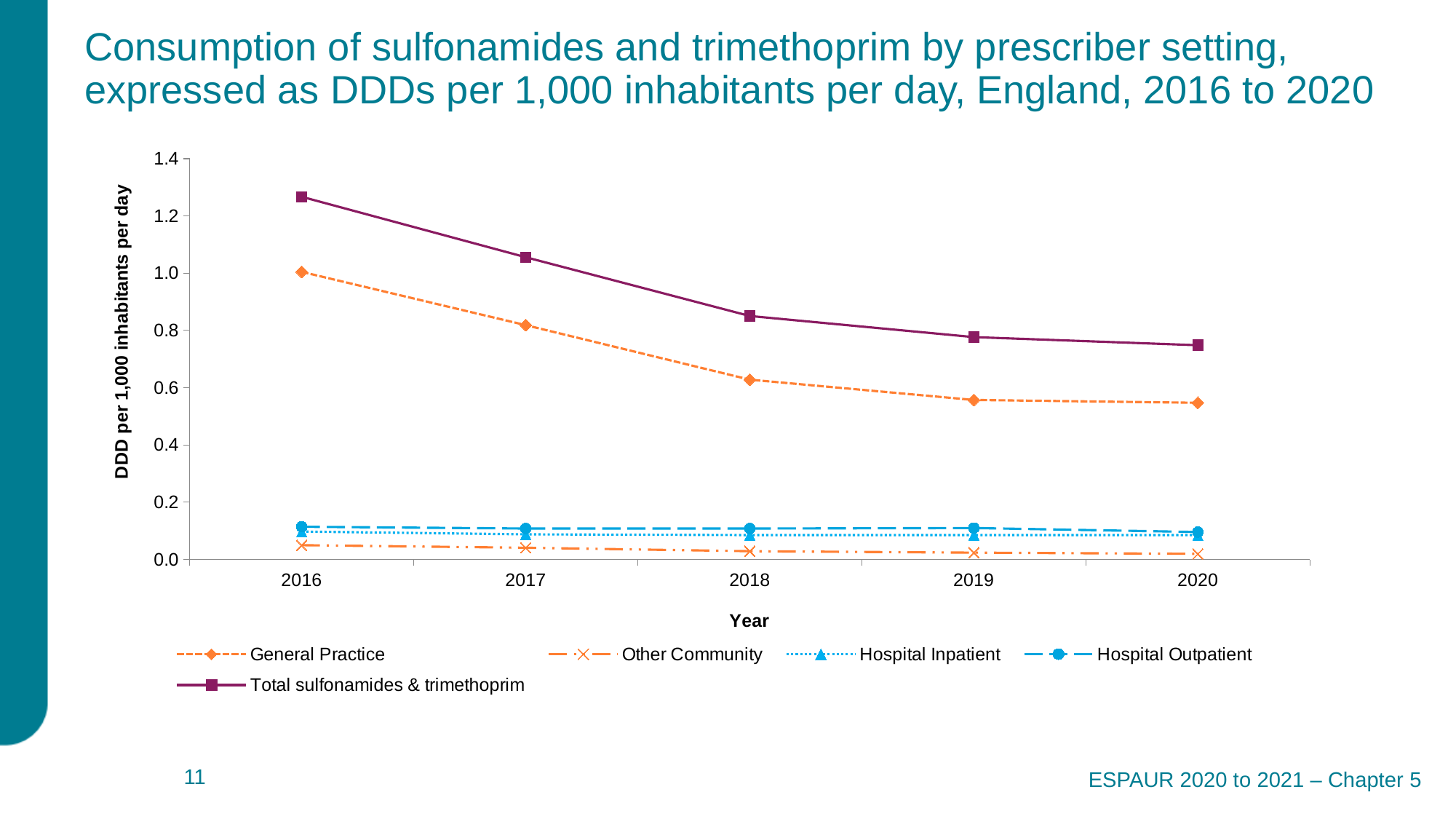
How many series does the legend list? 5 In which year is the General Practice value lowest? 2020 In which year is the Total sulfonamides & trimethoprim value highest? 2016 Does the Total sulfonamides & trimethoprim line rise or fall from 2016 to 2020? fall In 2018, which is larger: the General Practice value or the Hospital Inpatient value? General Practice Is the Total sulfonamides & trimethoprim value for 2016 greater or less than 1.2? greater Is the General Practice value for 2020 greater or less than 0.6? less What is the label on the y axis? DDD per 1,000 inhabitants per day Is the Total sulfonamides & trimethoprim value for 2020 greater or less than 0.8? less What kind of chart is shown on the slide? line chart How many years are plotted along the x axis? 5